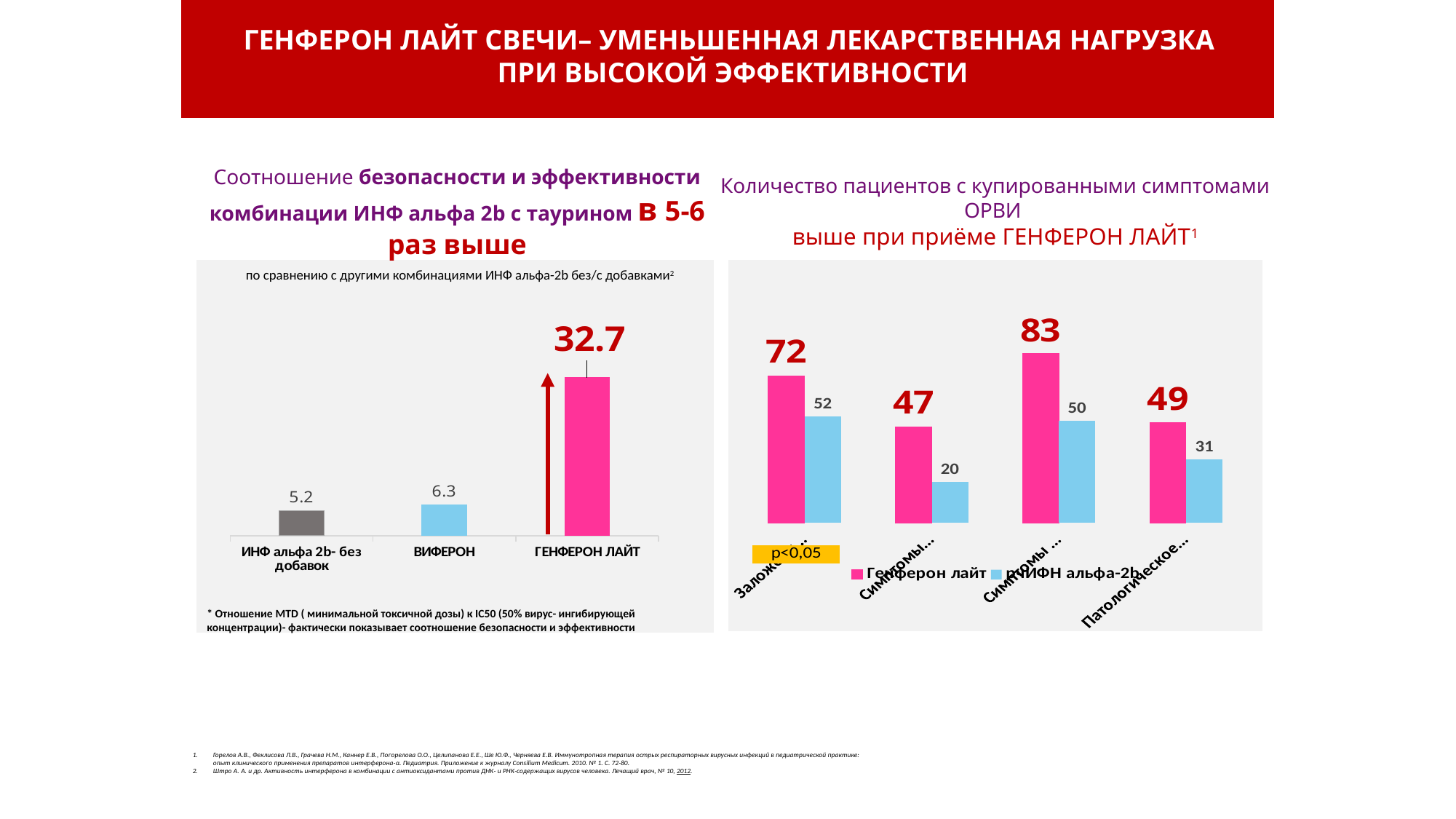
How many series does the legend of the right chart list? 2 In the right chart, what is the highest value for the Генферон лайт series? 83 In the left chart, what is the value for ВИФЕРОН? 6.3 In the right chart, in the first group of bars from the left, what is the difference between the Генферон лайт value and the рчИФН альфа-2b value? 20 In the left chart, what is the value for ГЕНФЕРОН ЛАЙТ? 32.7 What type of chart is the right chart? bar chart In the left chart, which category has the lowest value? ИНФ альфа 2b- без добавок In the left chart, what is the difference between the values for ГЕНФЕРОН ЛАЙТ and ВИФЕРОН? 26.4 In the right chart, what is the lowest value for the рчИФН альфа-2b series? 20 In the left chart, what is the value for ИНФ альфа 2b- без добавок? 5.2 In the right chart, which series is shown in pink? Генферон лайт How many categories are shown in the left chart? 3